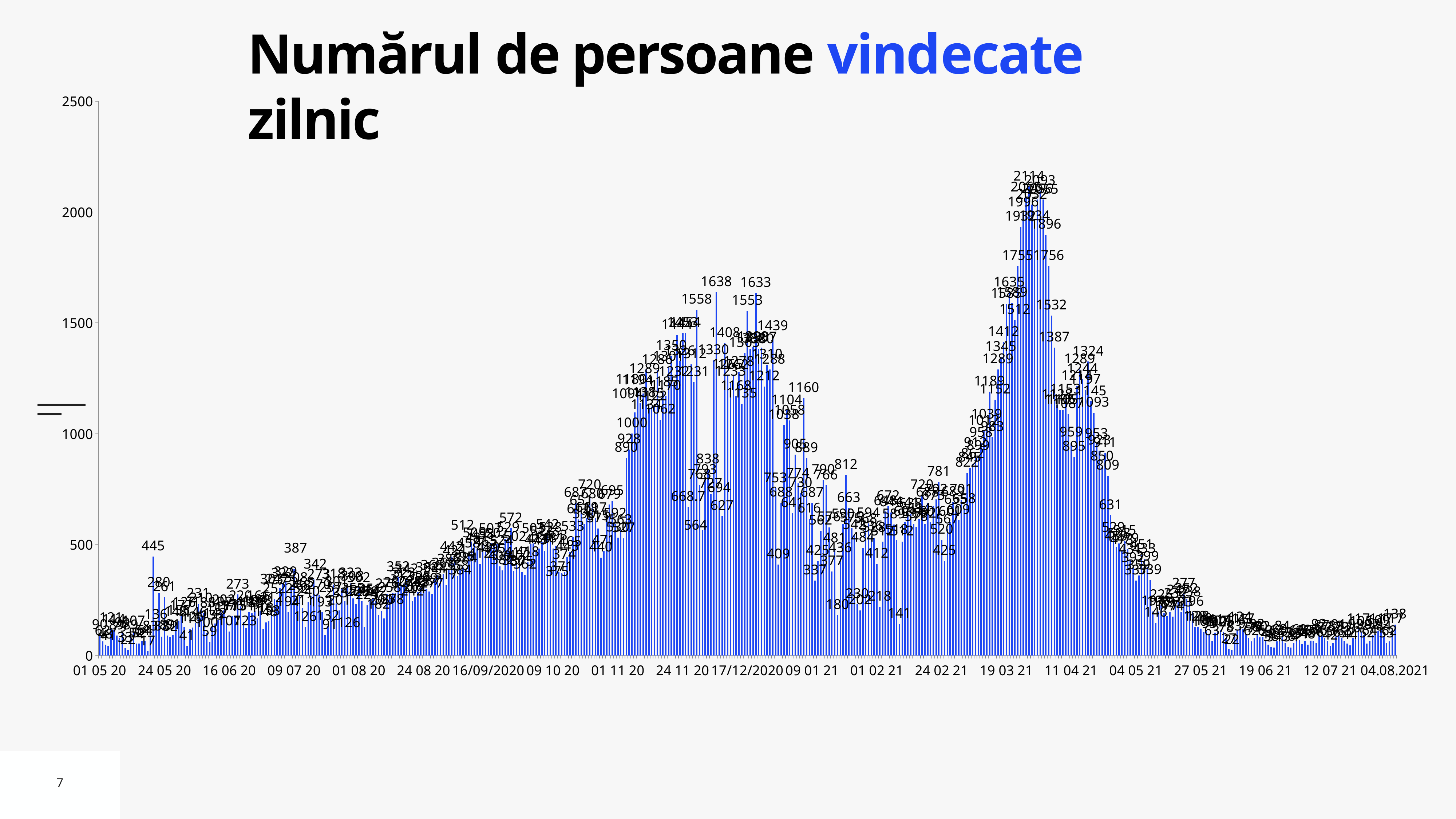
What is the first date label on the horizontal axis? 01 05 20 What is the highest value labelled in the peak around 24 11 20? 1638 Is the value for 04.08.2021 greater or less than 500? less What is the title of the chart? Numărul de persoane vindecate zilnic Which peak is higher: the one around 24 11 20 or the one between 19 03 21 and 11 04 21? the one between 19 03 21 and 11 04 21 What is the maximum value shown on the vertical axis? 2500 Do the values rise or fall from 24 02 21 to 19 03 21? rise What is the difference between the overall peak value (2114) and the peak value around 24 11 20 (1638)? 476 What is the highest daily value labelled on the chart? 2114 What kind of chart is shown on the slide? bar chart What is the value labelled on the last bar, at 04.08.2021? 138 Do the values rise or fall from 11 04 21 to 04 05 21? fall